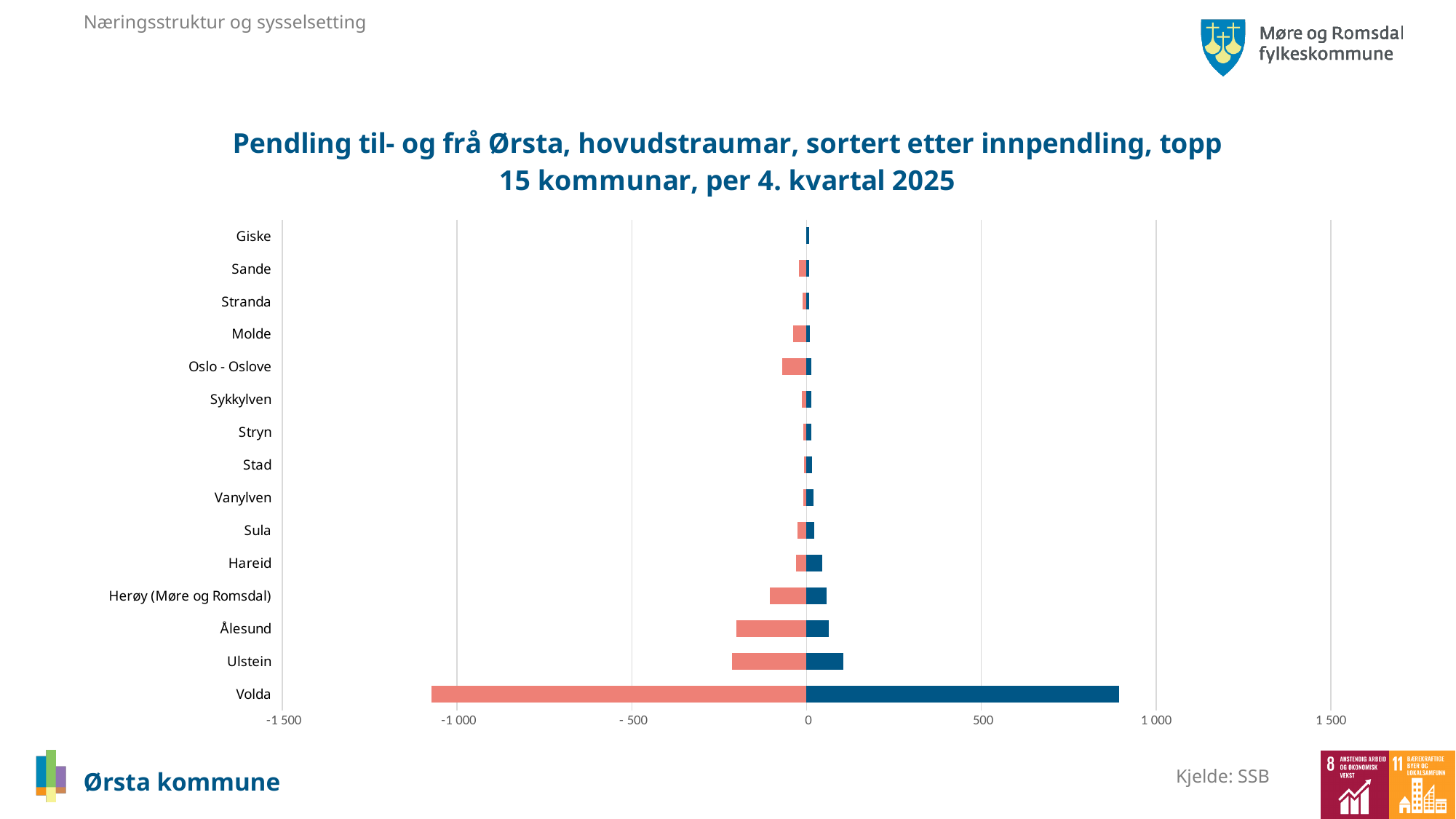
Which has the longer red bar, Oslo - Oslove or Molde? Oslo - Oslove Is the blue bar value for Ulstein greater or less than 500? less Does the red bar for Volda extend beyond -1 000 on the axis, i.e. is its value less than -1 000? less Is the blue bar value for Volda greater or less than 500? greater Which has the longer blue bar, Ulstein or Ålesund? Ulstein Which municipality has the longest red bar extending furthest to the left in the chart? Volda What kind of chart is shown on the slide? bar chart What source is cited for the chart data? SSB Which municipality has the longest blue bar (highest innpendling) in the chart? Volda What is the title of the chart? Pendling til- og frå Ørsta, hovudstraumar, sortert etter innpendling, topp 15 kommunar, per 4. kvartal 2025 How many municipalities (categories) are listed on the vertical axis of the chart? 15